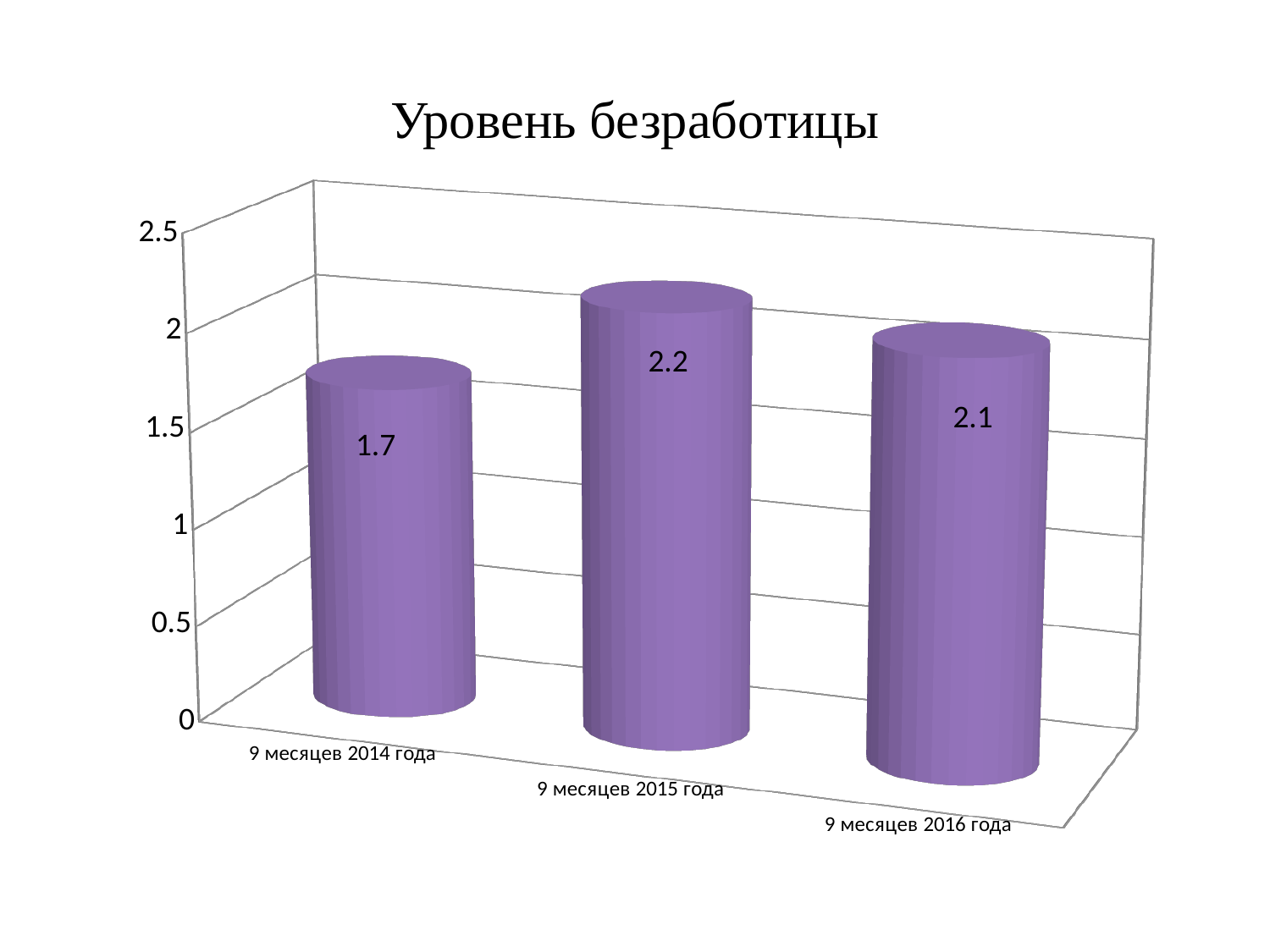
How many categories are shown on the chart? 3 Which category has the lowest value? 9 месяцев 2014 года Is the value for 9 месяцев 2014 года greater or less than 2? less What is the difference between the values for 9 месяцев 2015 года and 9 месяцев 2016 года? 0.1 What is the value for 9 месяцев 2014 года? 1.7 What is the title of the chart? Уровень безработицы Which is larger, the value for 9 месяцев 2014 года or the value for 9 месяцев 2016 года? 9 месяцев 2016 года What is the difference between the values for 9 месяцев 2015 года and 9 месяцев 2014 года? 0.5 What kind of chart is shown on the slide? bar chart Which category has the highest value? 9 месяцев 2015 года What is the value for 9 месяцев 2015 года? 2.2 What is the value for 9 месяцев 2016 года? 2.1